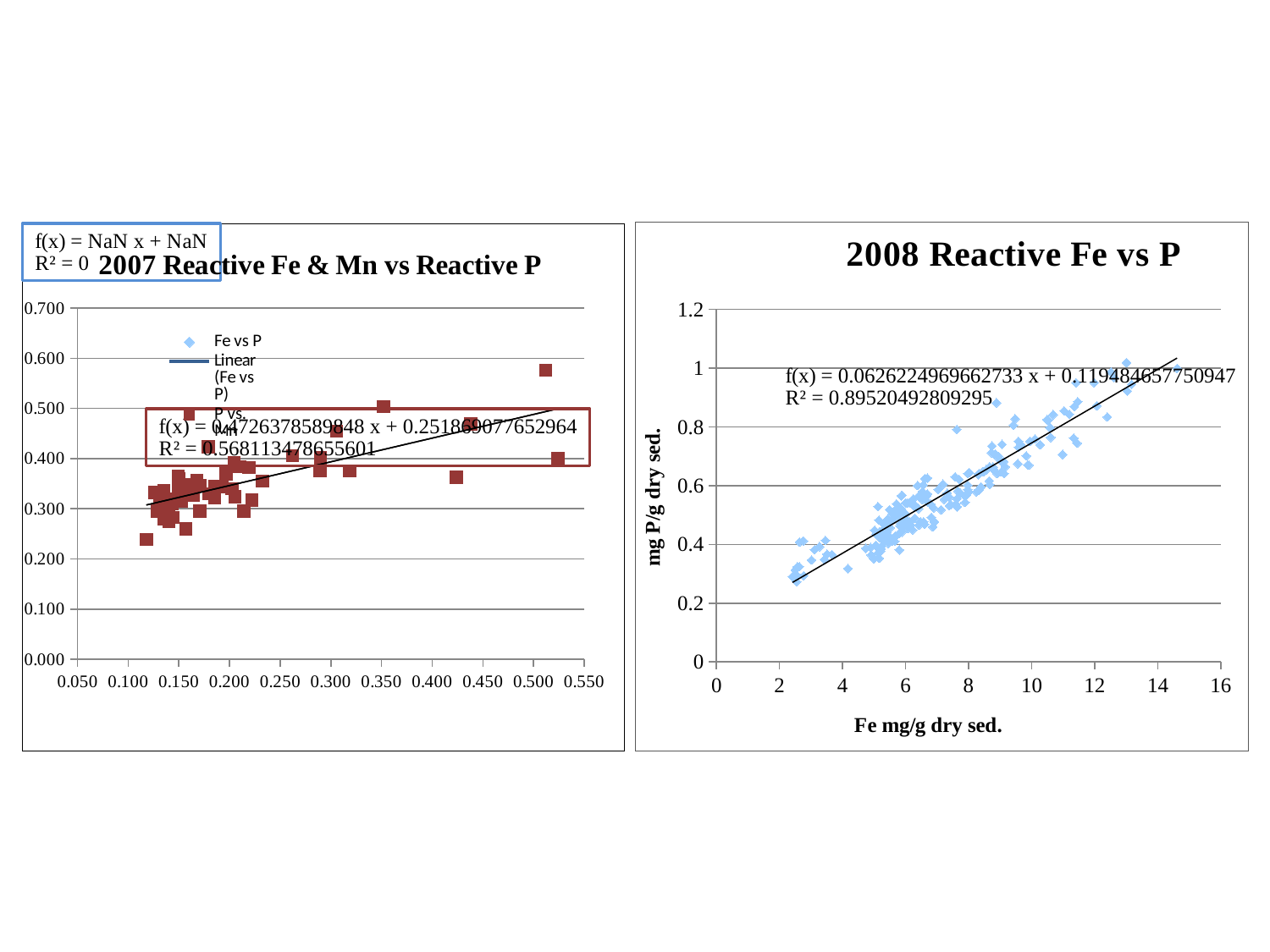
What R² value is printed in the boxed label on the left chart "2007 Reactive Fe & Mn vs Reactive P"? 0.568113478655601 In the right chart "2008 Reactive Fe vs P", is the highest plotted point greater or less than 0.8? greater What is the y-axis title of the right chart "2008 Reactive Fe vs P"? mg P/g dry sed. In the left chart "2007 Reactive Fe & Mn vs Reactive P", does the fitted trendline rise or fall along the x axis? Rise In the left chart "2007 Reactive Fe & Mn vs Reactive P", is the highest plotted point greater or less than 0.500? greater In the right chart "2008 Reactive Fe vs P", do the plotted values rise or fall as Fe increases along the x axis? Rise What R² value is printed on the right chart "2008 Reactive Fe vs P"? 0.89520492809295 What is the x-axis title of the right chart "2008 Reactive Fe vs P"? Fe mg/g dry sed. What kind of chart is the right chart titled "2008 Reactive Fe vs P"? Scatter chart Which chart shows the higher R² value, the 2007 chart on the left or the 2008 chart on the right? 2008 Reactive Fe vs P What kind of chart is the left chart titled "2007 Reactive Fe & Mn vs Reactive P"? Scatter chart In the left chart "2007 Reactive Fe & Mn vs Reactive P", is the lowest plotted point greater or less than 0.300? less